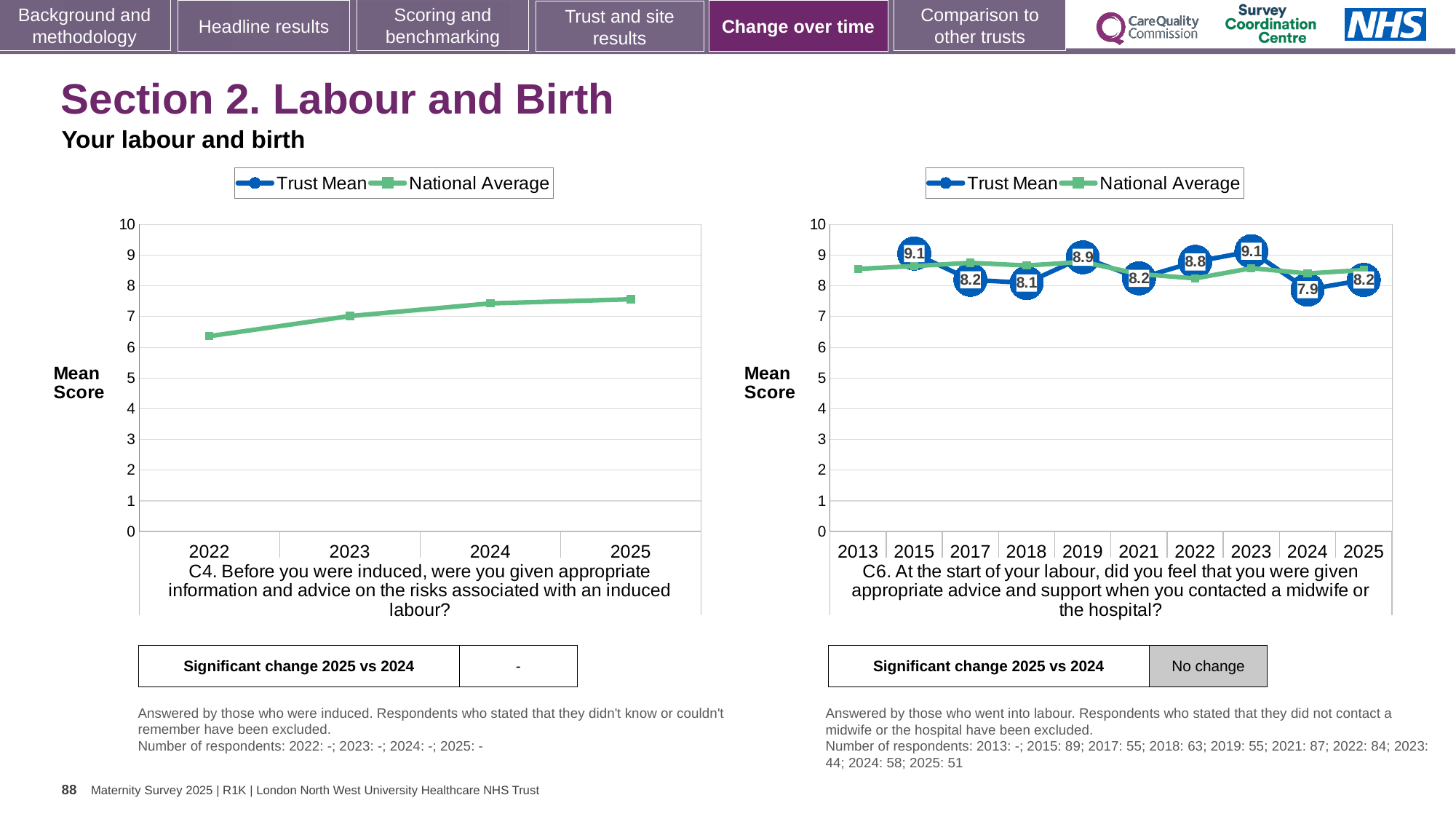
On the right chart (C6), what is the Trust Mean score for 2024? 7.9 What kind of chart is the right chart (C6)? line chart On the right chart (C6), what is the difference between the Trust Mean scores for 2025 and 2024? 0.3 On the right chart (C6), what is the Trust Mean score for 2025? 8.2 On the right chart (C6), in which year is the Trust Mean score lowest? 2024 On the right chart (C6), what is the Trust Mean score for 2019? 8.9 How many series does the legend of the left chart (C4) list? 2 On the left chart (C4), is the National Average value for 2025 greater or less than 7? greater On the left chart (C4), is the National Average value for 2022 greater or less than 7? less On the right chart (C6), which year has the higher Trust Mean score, 2018 or 2019? 2019 On the left chart (C4), does the National Average rise or fall from 2022 to 2025? rise On the right chart (C6), how many years are shown on the x axis? 10